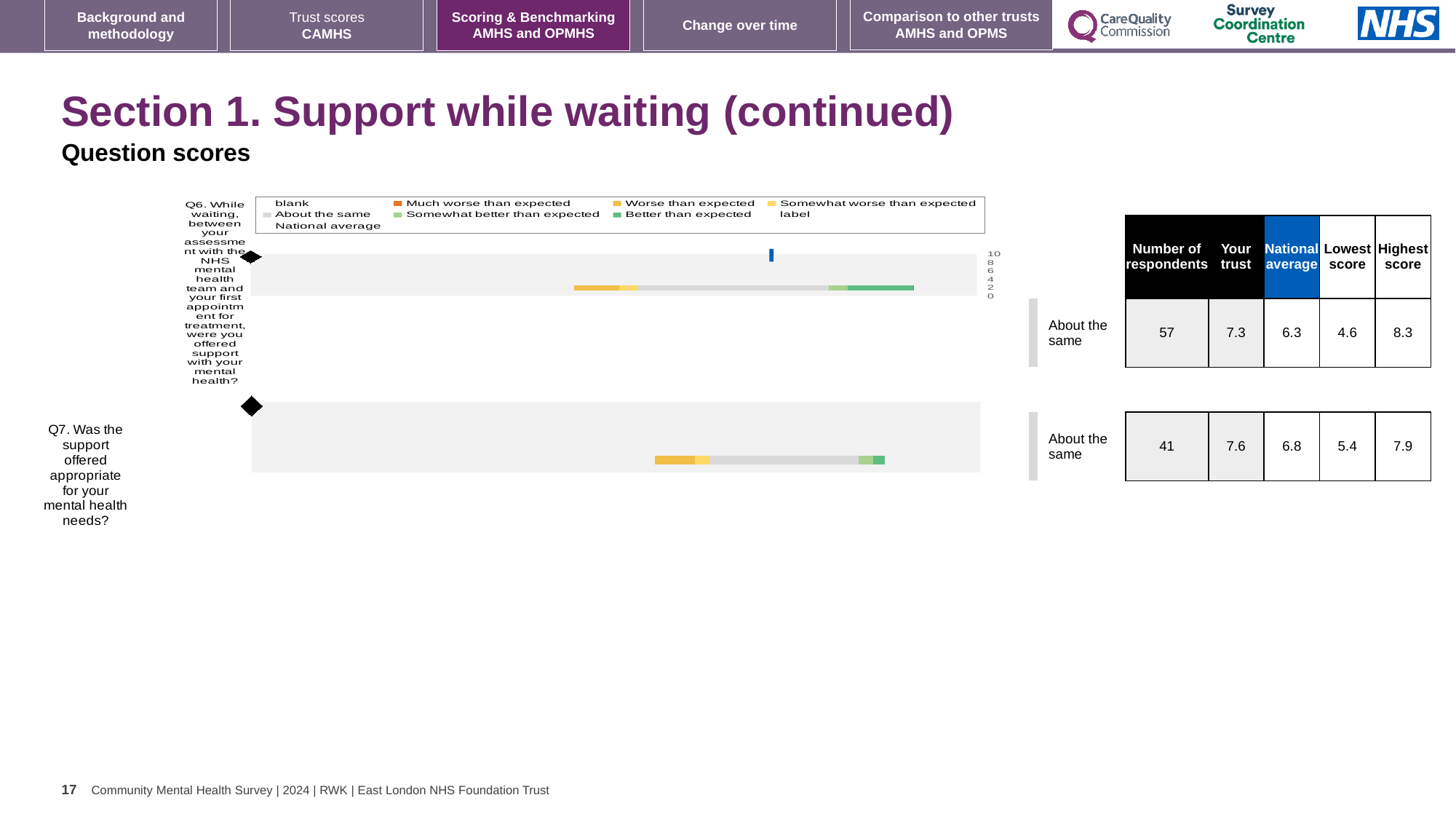
What is the difference between the 'Your trust' score and the national average for Q6? 1.0 How many survey questions are plotted in the chart? 2 What is the national average for Q7 in the table beside the chart? 6.8 What kind of chart is shown on the slide? bar chart What benchmark category is shown next to the chart for Q6? About the same Which question has the higher 'Your trust' score, Q6 or Q7? Q7 Is the 'Your trust' score for Q7 greater or less than 6? greater How many entries does the chart legend list? 9 How many respondents answered Q7? 41 Which colour in the chart legend represents 'Better than expected'? green What is the 'Your trust' score for Q6 in the table beside the chart? 7.3 What is the highest score listed for Q6? 8.3